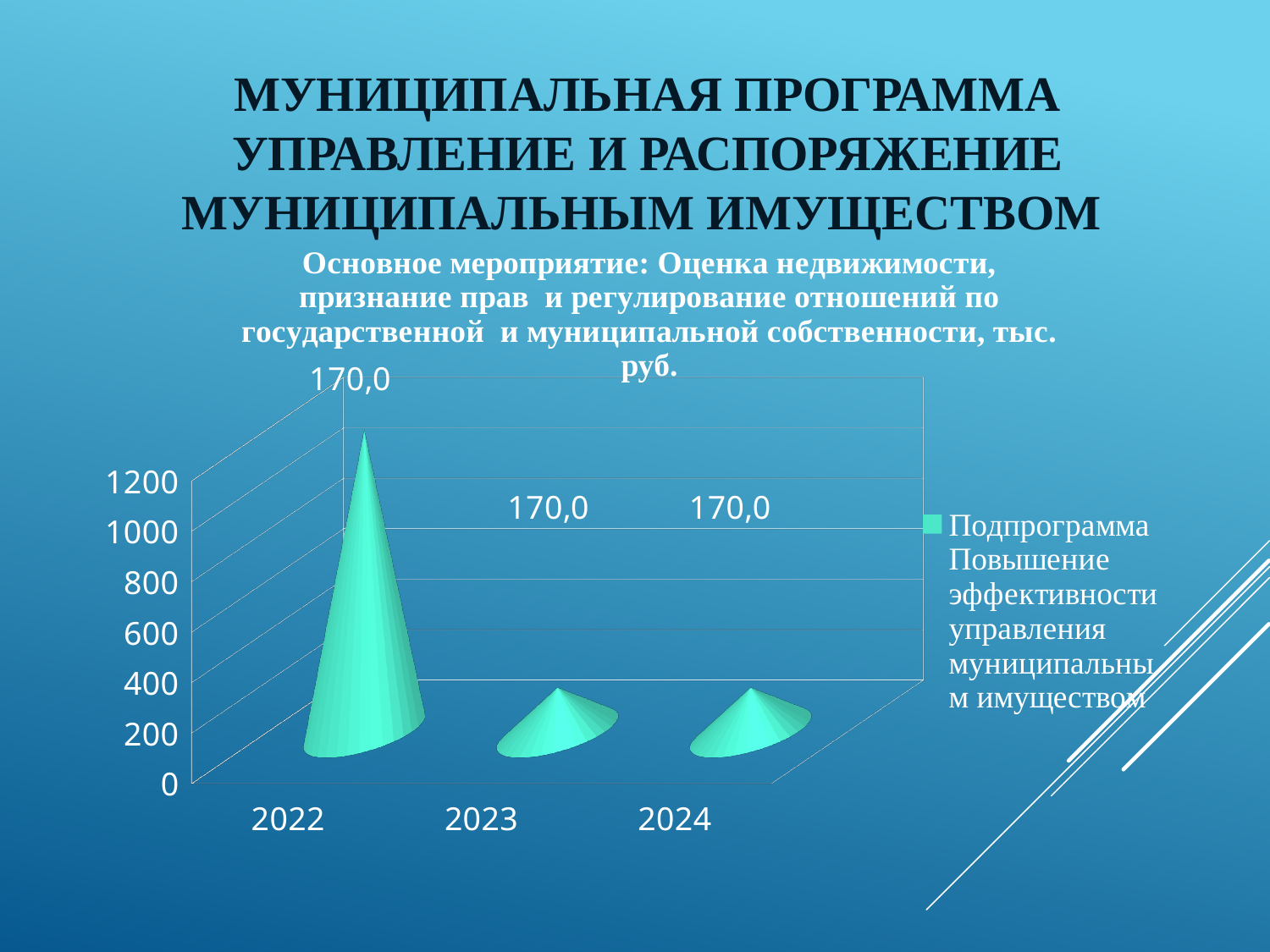
What is the first year shown on the x axis? 2022 Is the value for 2023 greater or less than 400? less What is the highest value shown on the vertical axis? 1200 What kind of chart is shown on the slide? bar chart How many series does the legend list? 1 What data label is printed above the 2022 bar? 170,0 How many years are shown on the x axis? 3 Is the value for 2024 greater or less than 600? less